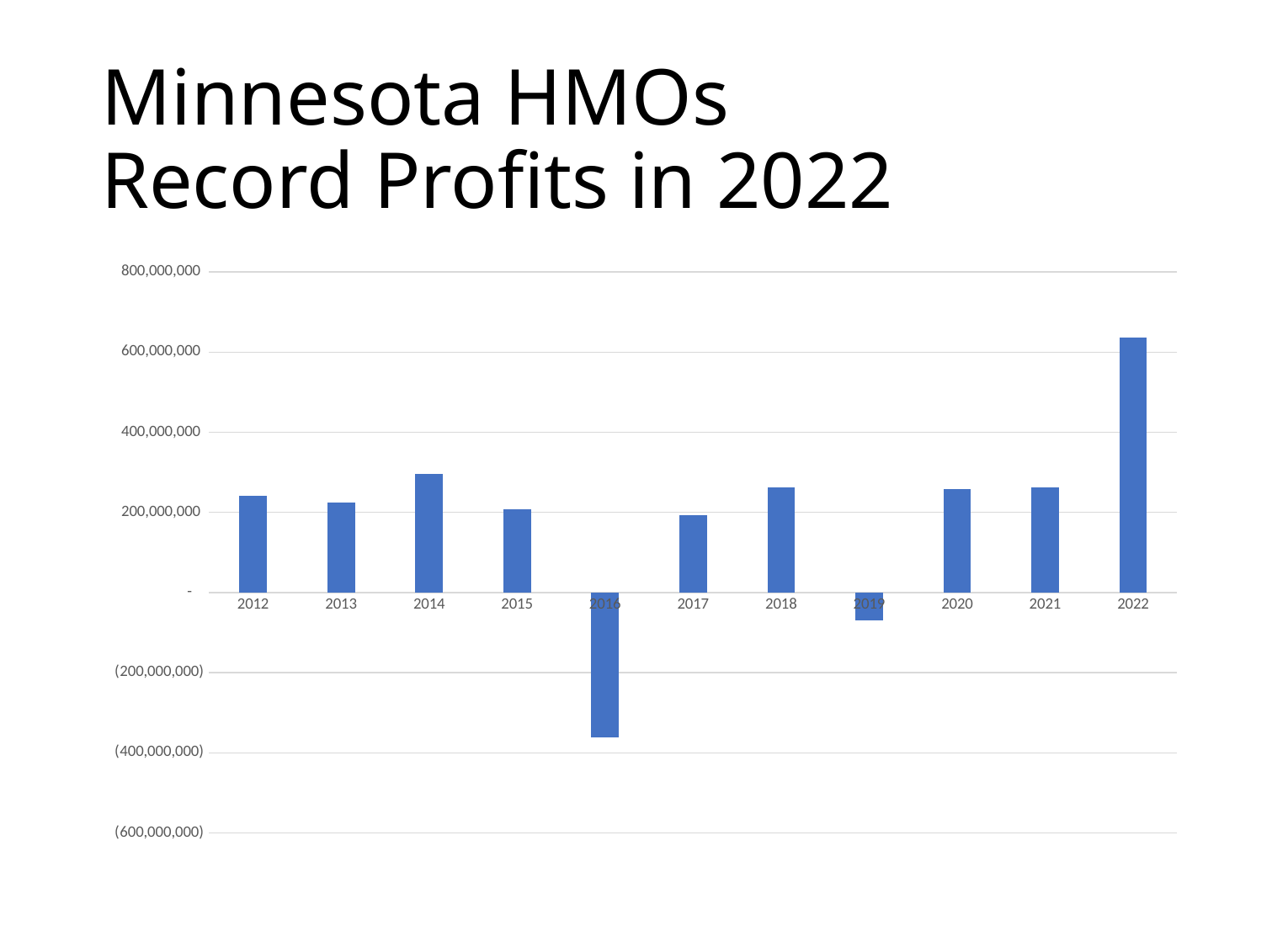
Is the value for 2014 greater or less than 200,000,000? greater Is the value for 2016 greater or less than (200,000,000)? less Which year has the lowest value on the chart? 2016 How many years on the chart have a negative value? 2 Which is larger, the value for 2022 or the value for 2014? 2022 What kind of chart is shown on the slide? bar chart How many years are plotted on the chart? 11 Which year has the highest value on the chart? 2022 Is the value for 2022 greater or less than 600,000,000? greater Which is larger, the value for 2014 or the value for 2013? 2014 What is the title of the slide? Minnesota HMOs Record Profits in 2022